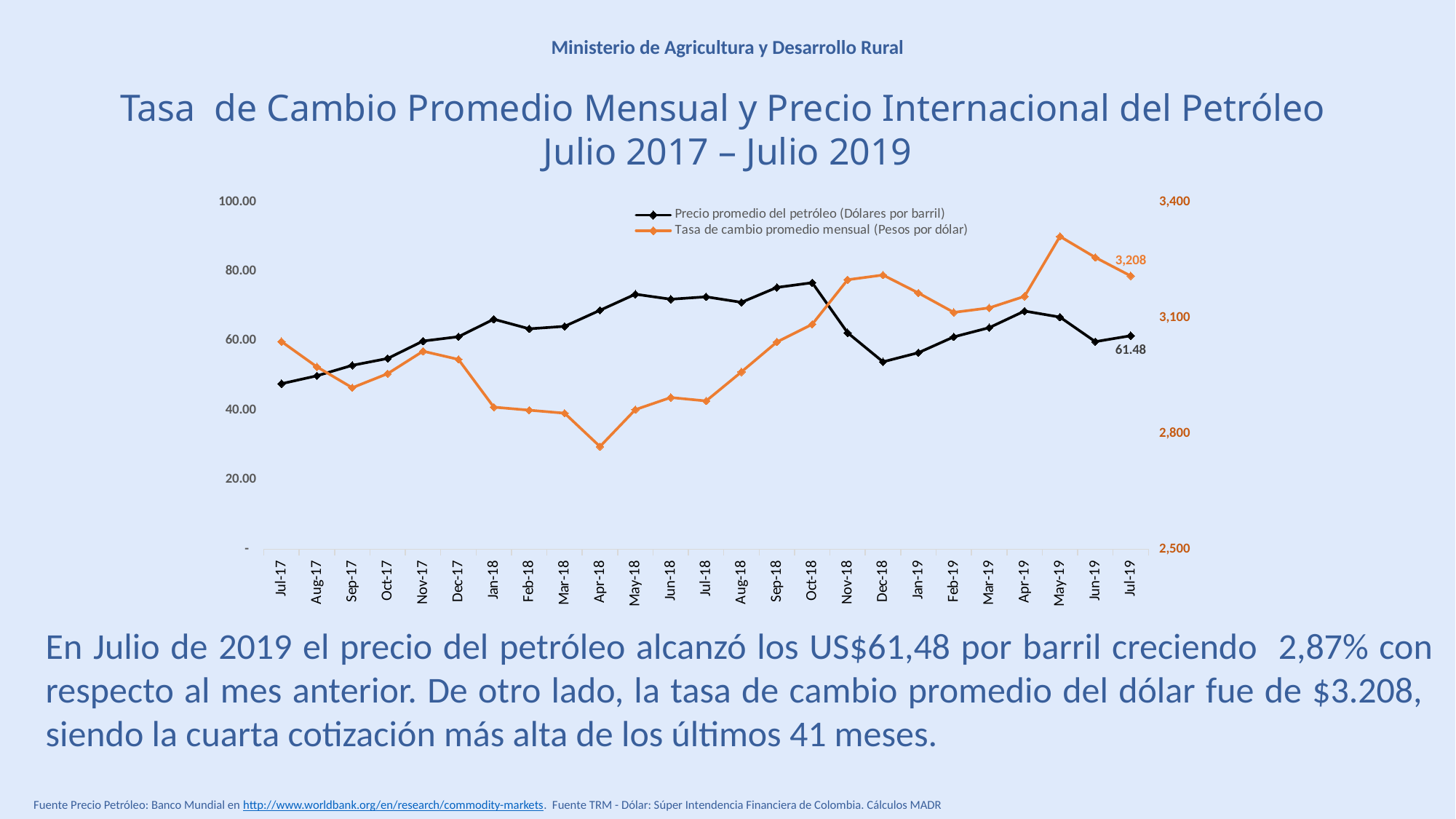
Which colour is used for the exchange rate (Tasa de cambio promedio mensual) series? Orange In which month does the oil price series reach its highest point? Oct-18 In which month does the exchange rate series reach its highest point? May-19 How many series does the legend list? 2 What kind of chart is shown on the slide? Line chart How many months are plotted along the x axis? 25 What is the labelled value of the oil price (Precio promedio del petróleo) for Jul-19? 61.48 Is the exchange rate for Apr-18 greater or less than 2,800? less Which month has the higher oil price, Oct-18 or Dec-18? Oct-18 Is the oil price for Apr-18 greater or less than 60.00? greater What is the labelled value of the exchange rate (Tasa de cambio promedio mensual) for Jul-19? 3,208 In which month does the exchange rate series reach its lowest point? Apr-18